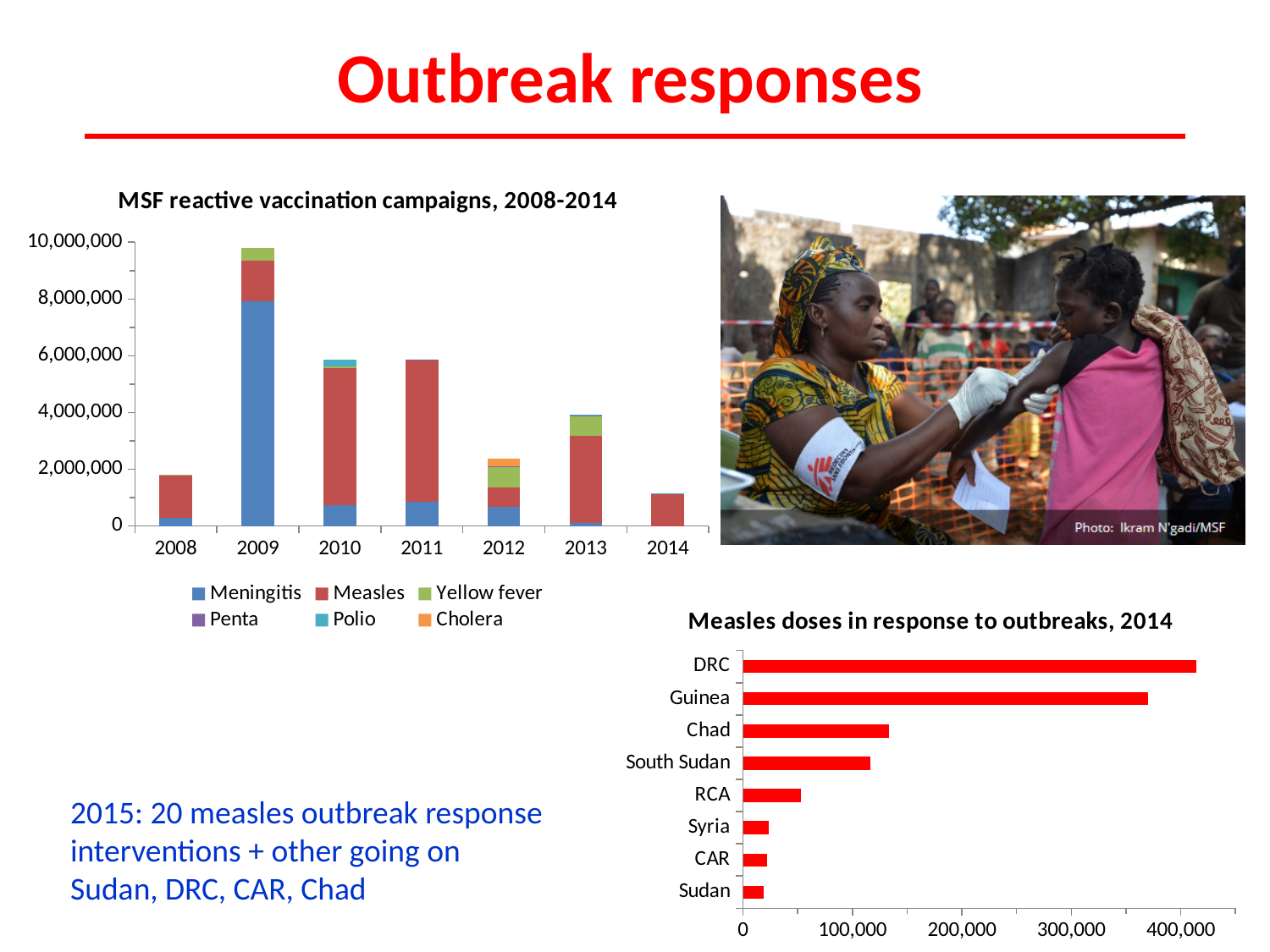
In the 'MSF reactive vaccination campaigns, 2008-2014' chart, which year has the highest total? 2009 In the 'Measles doses in response to outbreaks, 2014' chart, which country has the highest value? DRC In the 'MSF reactive vaccination campaigns, 2008-2014' chart, is the total for 2012 greater or less than 4,000,000? less In the 'Measles doses in response to outbreaks, 2014' chart, which is larger, the value for Chad or the value for RCA? Chad What type of chart is 'MSF reactive vaccination campaigns, 2008-2014'? Stacked bar chart How many years are shown on the x axis of the 'MSF reactive vaccination campaigns, 2008-2014' chart? 7 In the 'MSF reactive vaccination campaigns, 2008-2014' chart, is the total for 2009 greater or less than 8,000,000? greater In the 'MSF reactive vaccination campaigns, 2008-2014' chart, which series is shown in blue? Meningitis In the 'Measles doses in response to outbreaks, 2014' chart, is the value for Guinea greater or less than 400,000? less In the 'MSF reactive vaccination campaigns, 2008-2014' chart, which year has the lowest total? 2014 How many countries are shown in the 'Measles doses in response to outbreaks, 2014' chart? 8 How many series does the legend of the 'MSF reactive vaccination campaigns, 2008-2014' chart list? 6